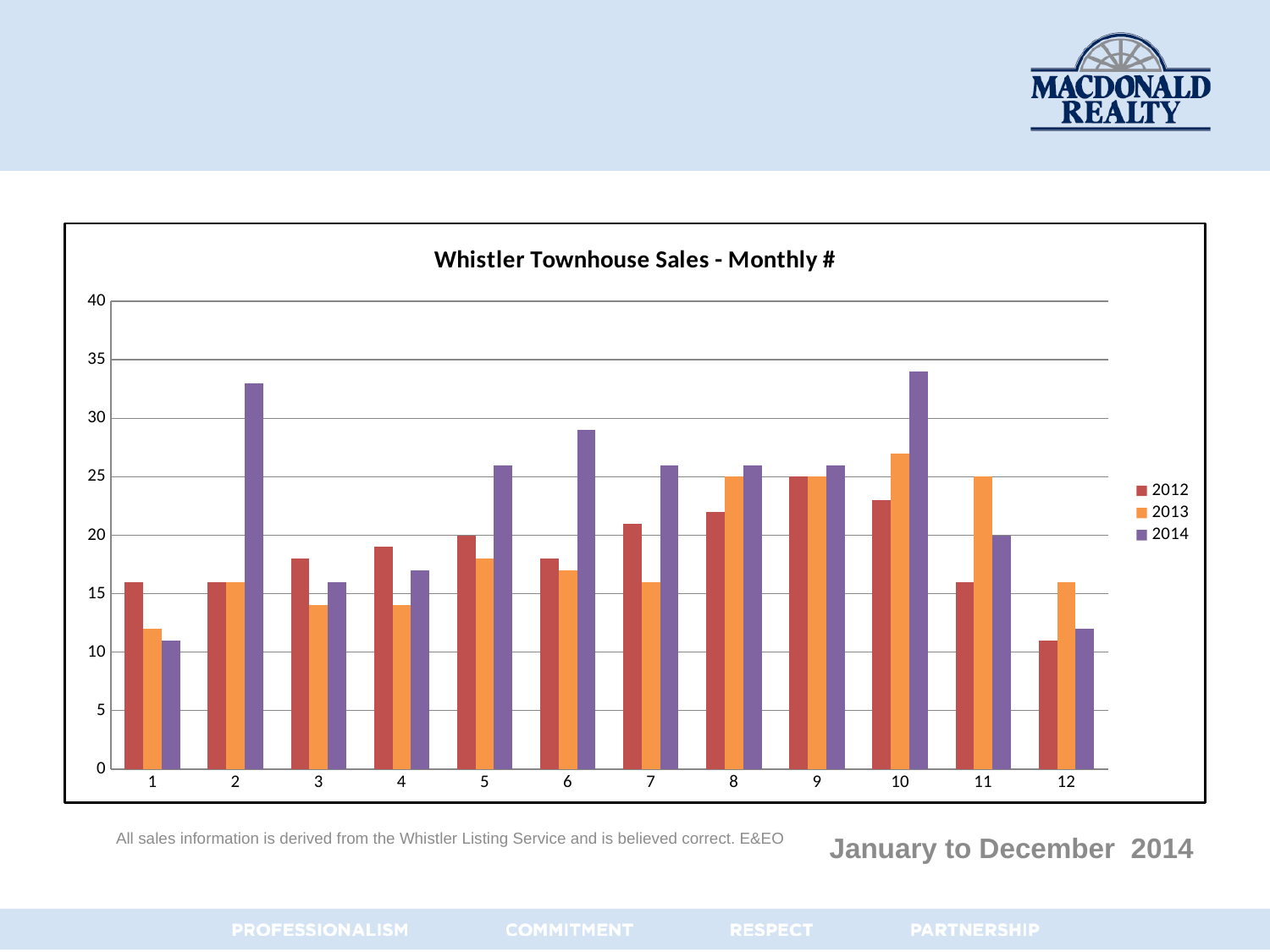
Is the 2014 value for month 1 greater or less than 15? less In month 2, which series has the larger value, 2012 or 2014? 2014 Is the 2014 value for month 6 greater or less than 25? greater What kind of chart is shown on the slide? bar chart How many series does the legend list? 3 Is the 2014 value for month 2 greater or less than 30? greater In month 12, which series has the larger value, 2013 or 2014? 2013 How many months (categories) are shown on the x axis? 12 What is the title of the chart? Whistler Townhouse Sales - Monthly # Which series is shown in purple? 2014 Which month has the lowest value for the 2012 series? 12